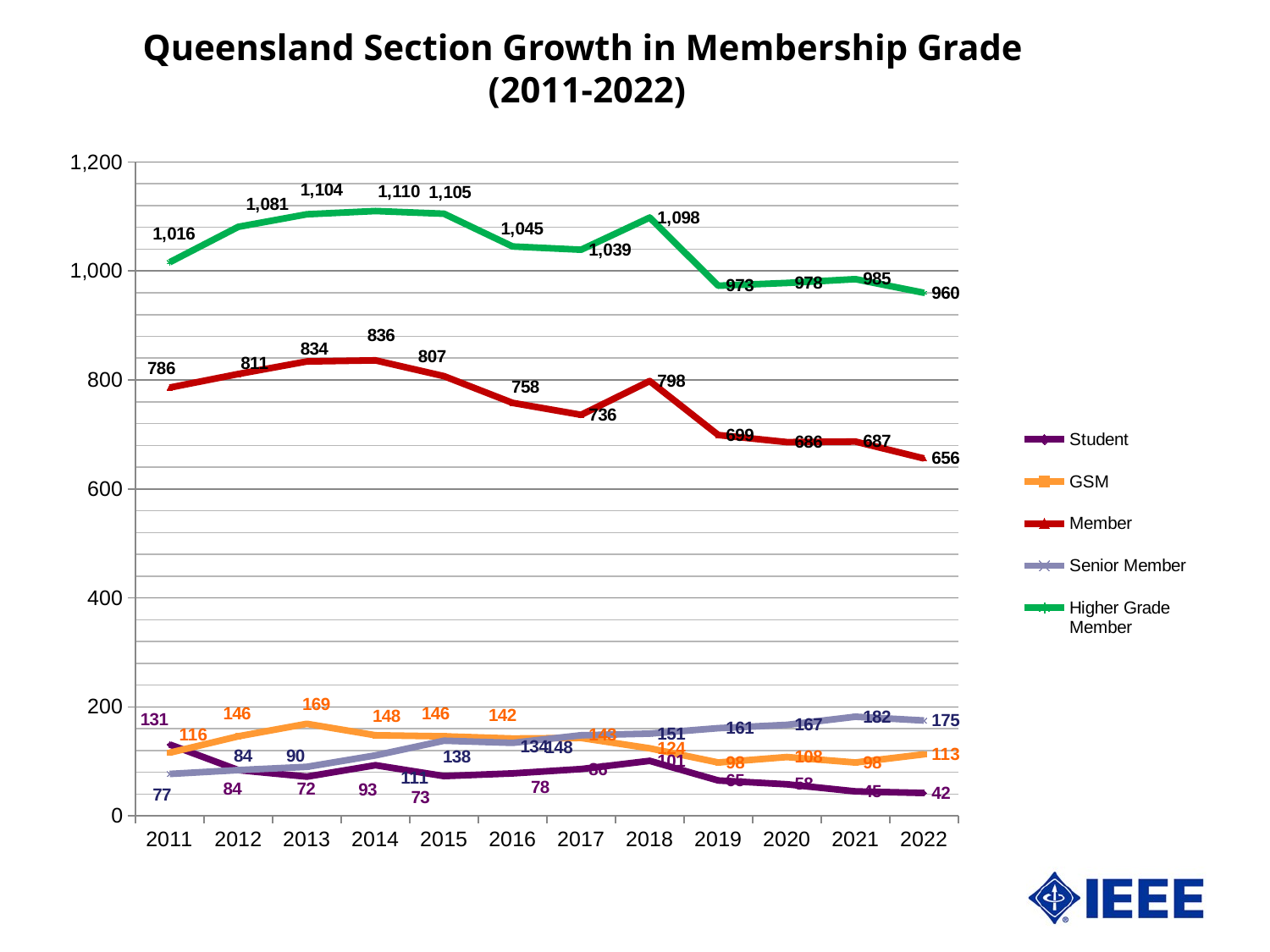
What is the Member value for 2022? 656 How many years are plotted along the x axis? 12 In which year is the Higher Grade Member series at its highest? 2014 Which is larger in 2021, the Senior Member value or the GSM value? Senior Member What is the Higher Grade Member value for 2014? 1,110 In which year is the Member series at its lowest? 2022 What is the title of the chart? Queensland Section Growth in Membership Grade (2011-2022) Is the Higher Grade Member value for 2019 greater or less than 1,000? less What is the difference between the Member value in 2011 and in 2022? 130 What is the Senior Member value for 2022? 175 What kind of chart is shown on the slide? line chart How many series does the legend list? 5